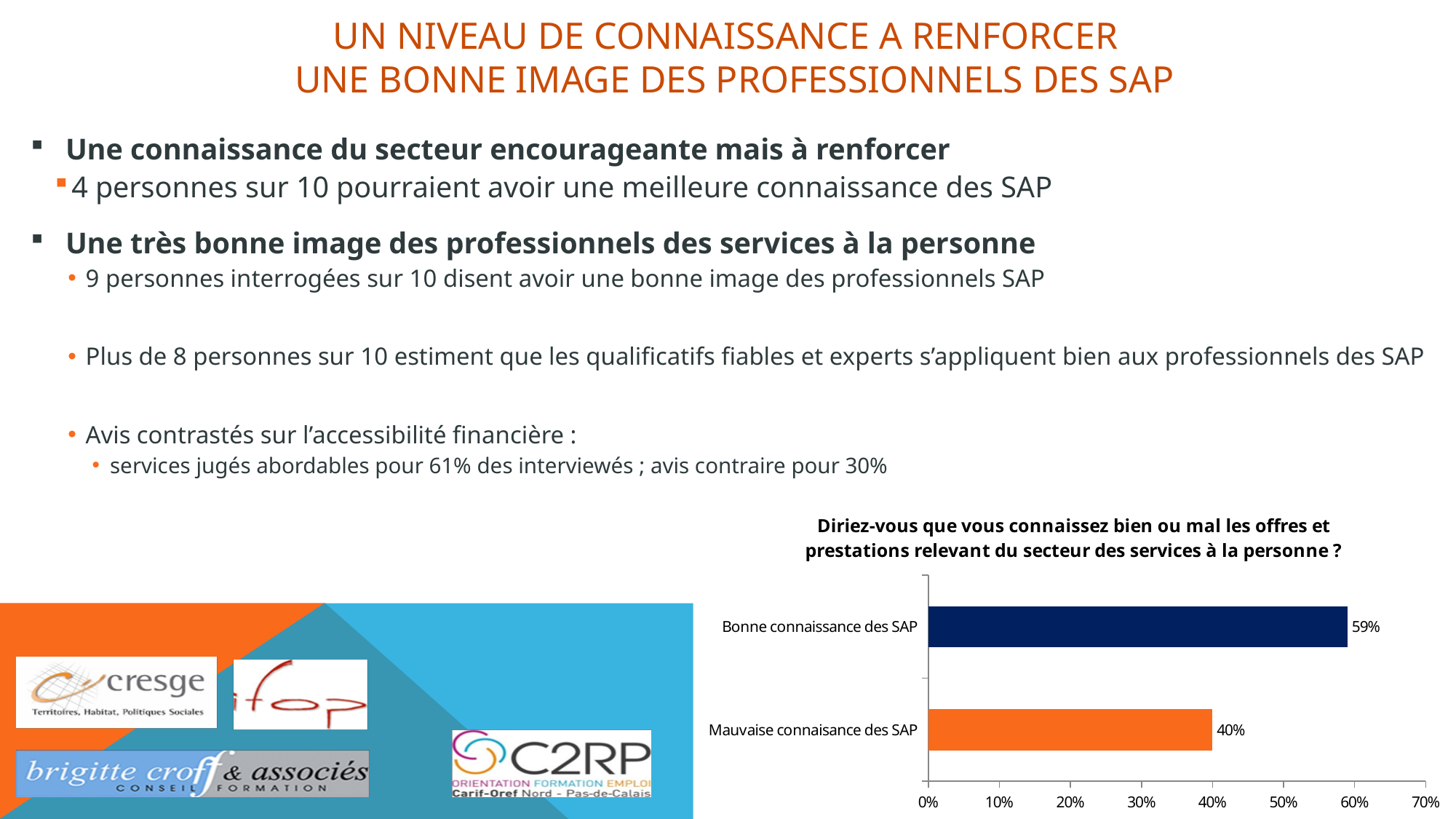
Is the value for "Bonne connaissance des SAP" greater or less than 50%? greater Is the value for "Mauvaise connaisance des SAP" greater or less than 50%? less What kind of chart is shown on the slide? Bar chart What is the title of the chart? Diriez-vous que vous connaissez bien ou mal les offres et prestations relevant du secteur des services à la personne ? What is the value for "Mauvaise connaisance des SAP"? 40% How many categories are shown in the chart? 2 Which category has the lowest value? Mauvaise connaisance des SAP What is the value for "Bonne connaissance des SAP"? 59% Which category has the highest value? Bonne connaissance des SAP What is the maximum value shown on the chart's horizontal axis? 70% Which is larger: the value for "Bonne connaissance des SAP" or for "Mauvaise connaisance des SAP"? Bonne connaissance des SAP What is the difference between the values for "Bonne connaissance des SAP" and "Mauvaise connaisance des SAP"? 19%